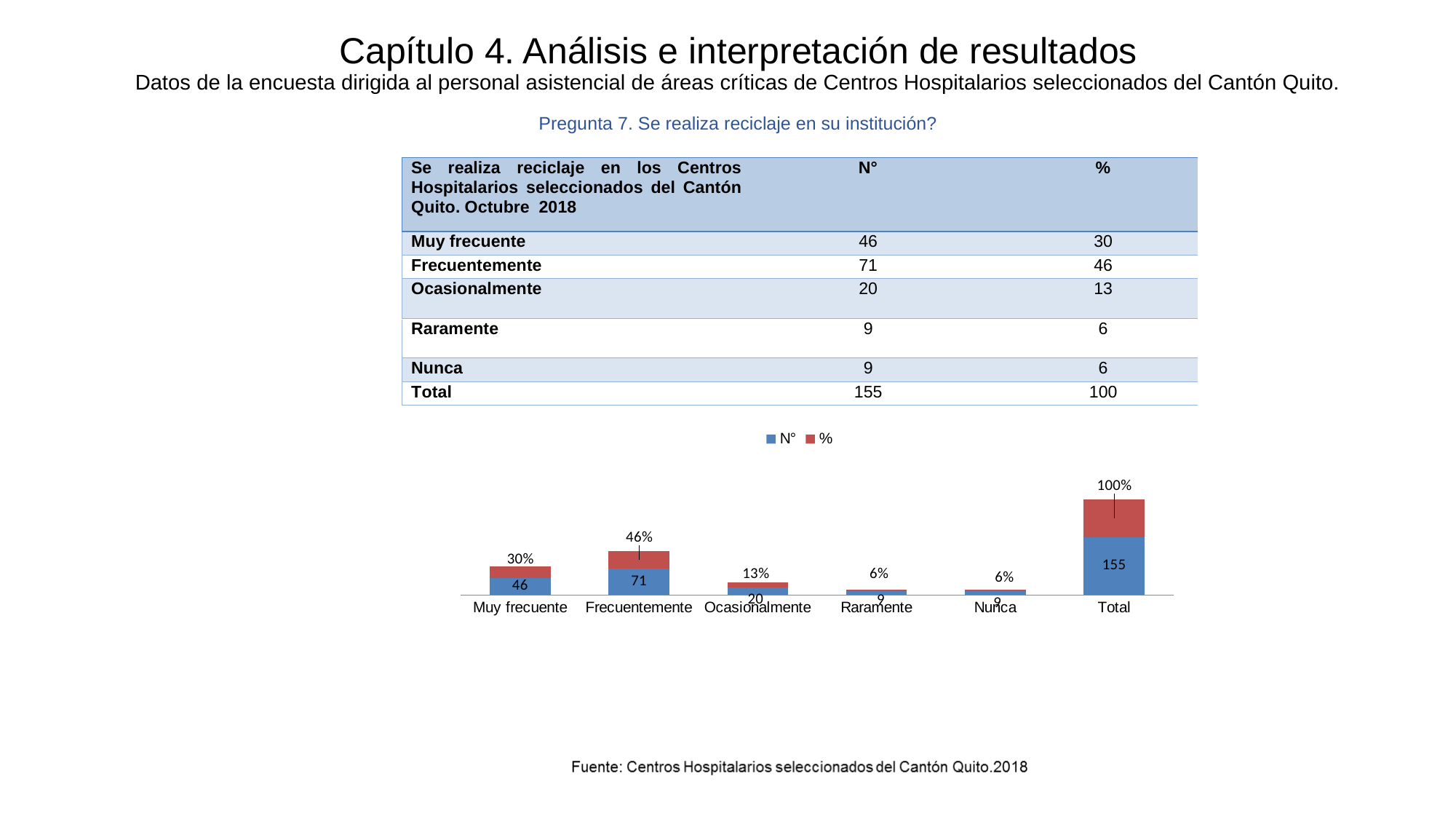
Which has a larger N° value, Muy frecuente or Ocasionalmente? Muy frecuente How many series does the chart legend list? 2 What percentage is shown for Ocasionalmente? 13% Excluding Total, which category has the highest N° value? Frecuentemente How many categories are shown on the x axis of the chart? 6 What is the N° value for Frecuentemente in the chart? 71 What type of chart is shown on the slide? Stacked bar chart What is the N° value shown for Total in the chart? 155 What is the difference between the N° values for Frecuentemente and Muy frecuente? 25 What percentage label is shown above the Muy frecuente bar? 30% What are the two series names in the chart legend? N° and % Excluding Total, which category has the lowest percentage? Raramente and Nunca (6%)